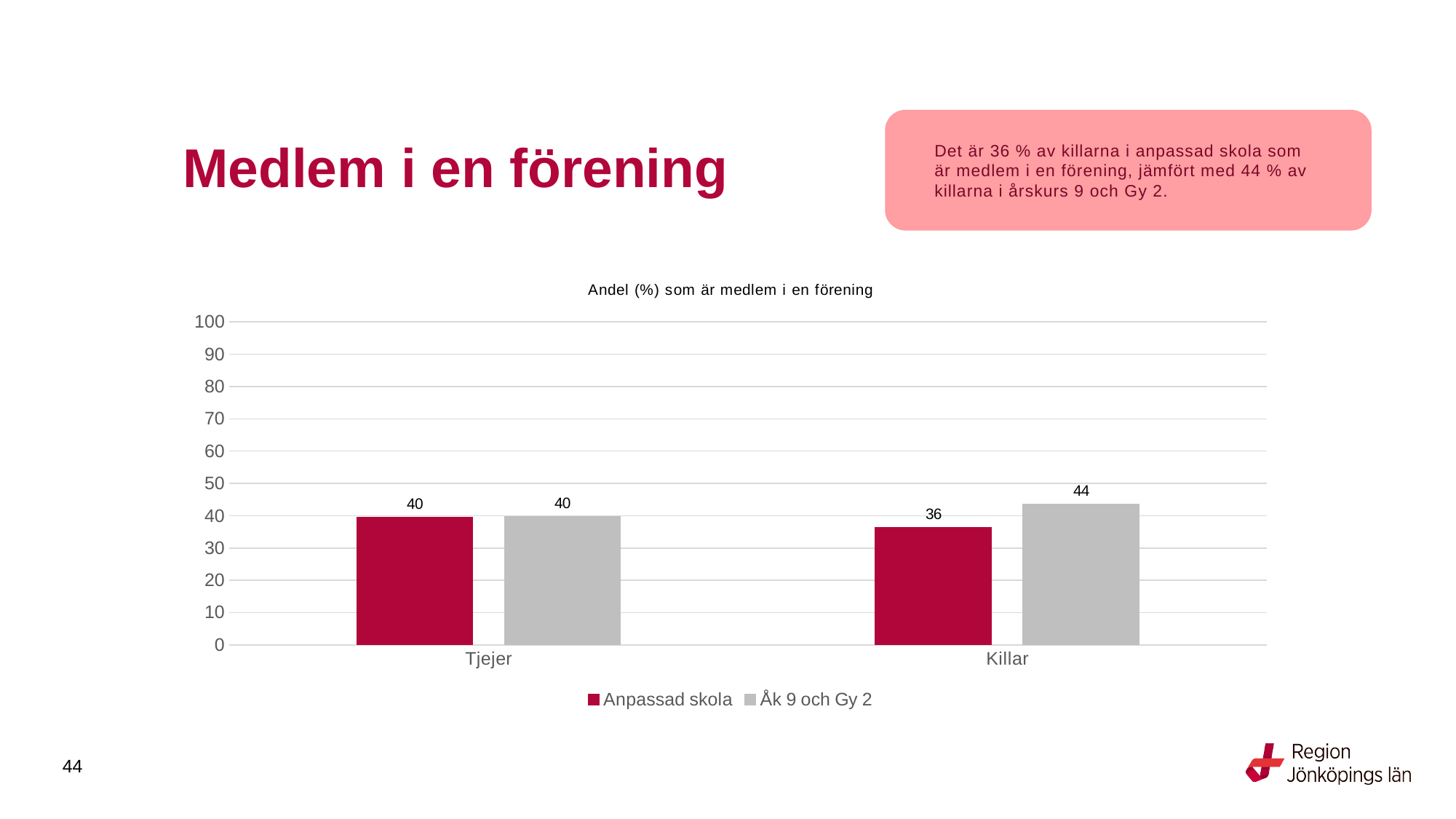
How many categories are shown on the x axis? 2 Which category has the highest value in the Åk 9 och Gy 2 series? Killar Which category has the lowest value in the Anpassad skola series? Killar What is the value for Killar in the Åk 9 och Gy 2 series? 44 What is the difference between the Åk 9 och Gy 2 value and the Anpassad skola value for Killar? 8 How many series does the legend list? 2 What is the value for Killar in the Anpassad skola series? 36 What kind of chart is shown on the slide? bar chart Is the value for Killar in the Anpassad skola series greater or less than 50? less What is the value for Tjejer in the Anpassad skola series? 40 What is the value for Tjejer in the Åk 9 och Gy 2 series? 40 For Killar, which series has the larger value: Anpassad skola or Åk 9 och Gy 2? Åk 9 och Gy 2